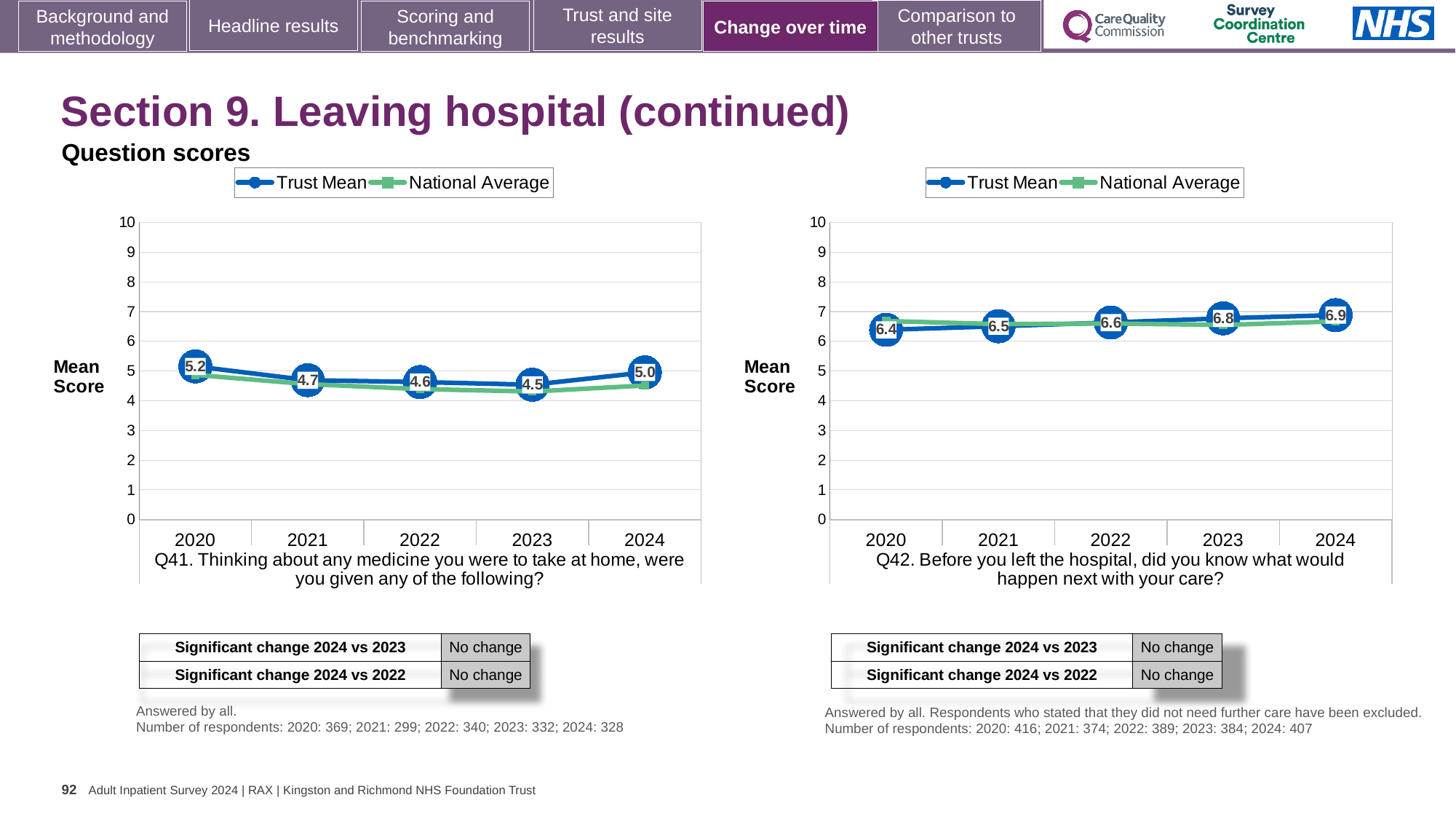
In the Q41 chart on the left, what is the Trust Mean score for 2024? 5.0 In the Q42 chart on the right, what is the difference between the Trust Mean scores for 2024 and 2020? 0.5 How many years are plotted on the x axis of the Q42 chart on the right? 5 In the Q42 chart on the right, is the Trust Mean score higher in 2021 or in 2024? 2024 In the Q41 chart on the left, what is the difference between the Trust Mean scores for 2020 and 2023? 0.7 In the Q42 chart on the right, what is the Trust Mean score for 2023? 6.8 In the Q41 chart on the left, what is the Trust Mean score for 2020? 5.2 In the Q41 chart on the left, which year has the lowest Trust Mean score? 2023 How many series does the legend of the Q41 chart on the left list? 2 In the Q41 chart on the left, is the National Average value for 2024 greater or less than 6? less In the Q42 chart on the right, does the Trust Mean score rise or fall from 2020 to 2024? rise In the Q42 chart on the right, which year has the highest Trust Mean score? 2024